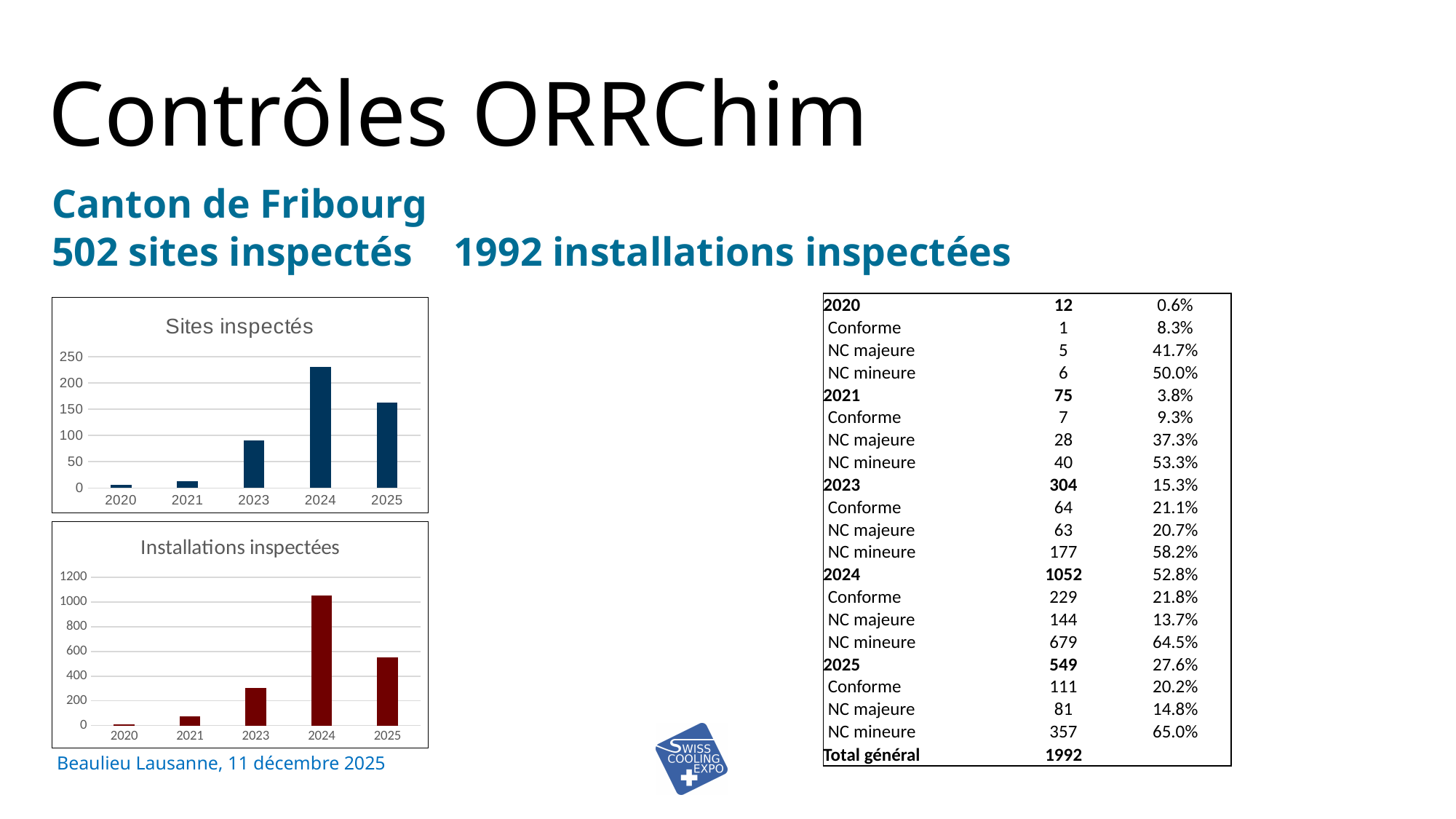
How many years are shown on the x axis of the 'Sites inspectés' chart? 5 In the 'Sites inspectés' chart, is the value for 2024 greater or less than 200? greater In the 'Installations inspectées' chart, which is larger, the value for 2023 or the value for 2025? 2025 In the 'Installations inspectées' chart, which year has the highest value? 2024 In the 'Installations inspectées' chart, is the value for 2024 greater or less than 1000? greater In the 'Installations inspectées' chart, is the value for 2025 greater or less than 600? less What colour are the bars in the 'Installations inspectées' chart? dark red In the 'Sites inspectés' chart, which year has the lowest value? 2020 What kind of chart is the 'Installations inspectées' chart? bar chart In the 'Sites inspectés' chart, which year has the highest value? 2024